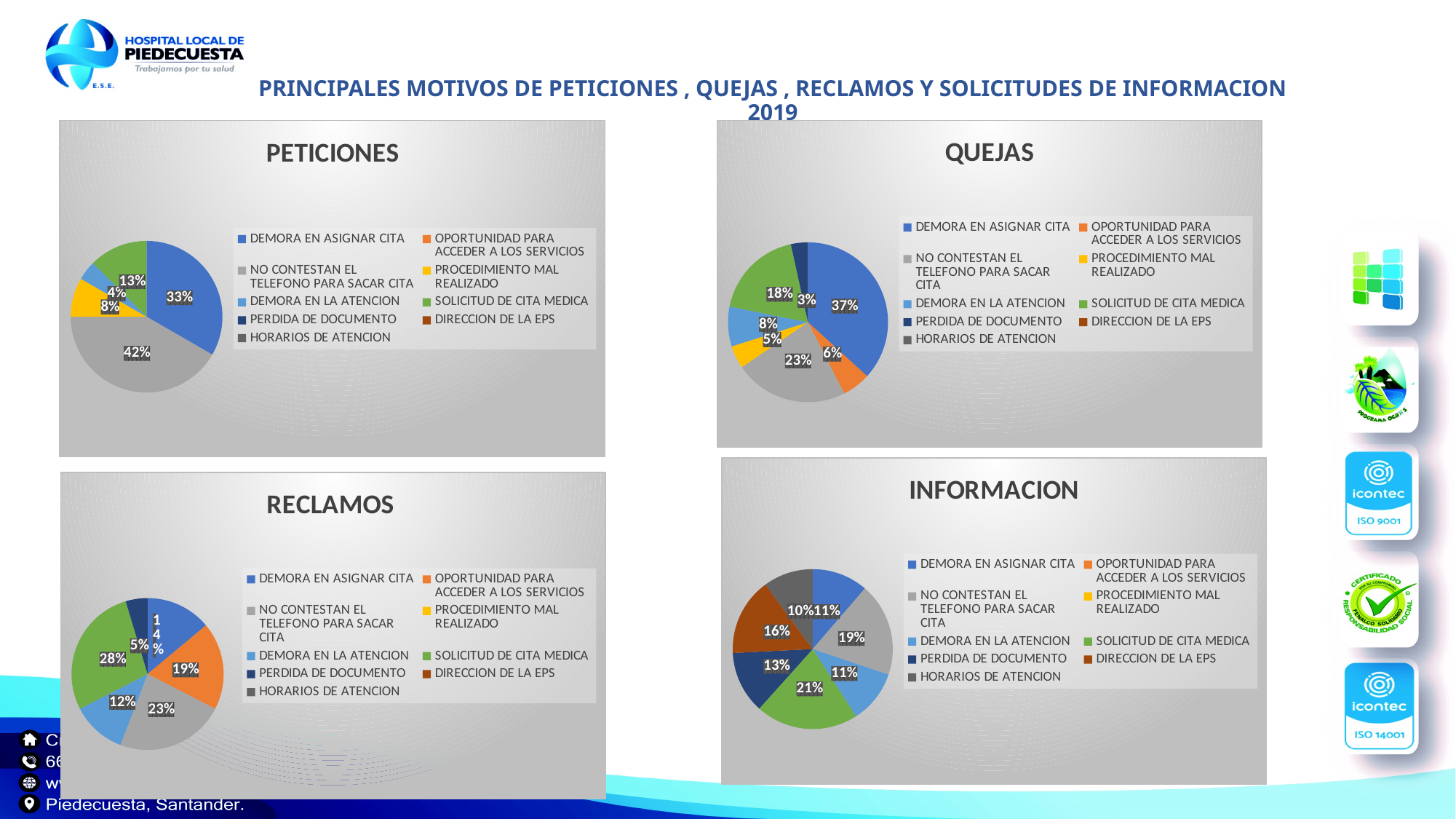
In the INFORMACION chart, which category has the largest share? SOLICITUD DE CITA MEDICA What type of chart is used for the QUEJAS data? Pie chart In the QUEJAS chart, which category has the largest share? DEMORA EN ASIGNAR CITA In the RECLAMOS chart, what percentage is shown for SOLICITUD DE CITA MEDICA? 28% In the RECLAMOS chart, which is larger: OPORTUNIDAD PARA ACCEDER A LOS SERVICIOS or DEMORA EN LA ATENCION? OPORTUNIDAD PARA ACCEDER A LOS SERVICIOS In the PETICIONES chart, which category has the smallest slice? DEMORA EN LA ATENCION In the PETICIONES chart, what percentage is shown for NO CONTESTAN EL TELEFONO PARA SACAR CITA? 42% How many entries does the legend of the RECLAMOS chart list? 9 In the INFORMACION chart, what percentage is shown for DIRECCION DE LA EPS? 16% In the QUEJAS chart, what percentage is shown for DEMORA EN ASIGNAR CITA? 37% In the INFORMACION chart, what is the difference between the shares for SOLICITUD DE CITA MEDICA and HORARIOS DE ATENCION? 11% In the QUEJAS chart, what is the difference between the shares for DEMORA EN ASIGNAR CITA and NO CONTESTAN EL TELEFONO PARA SACAR CITA? 14%